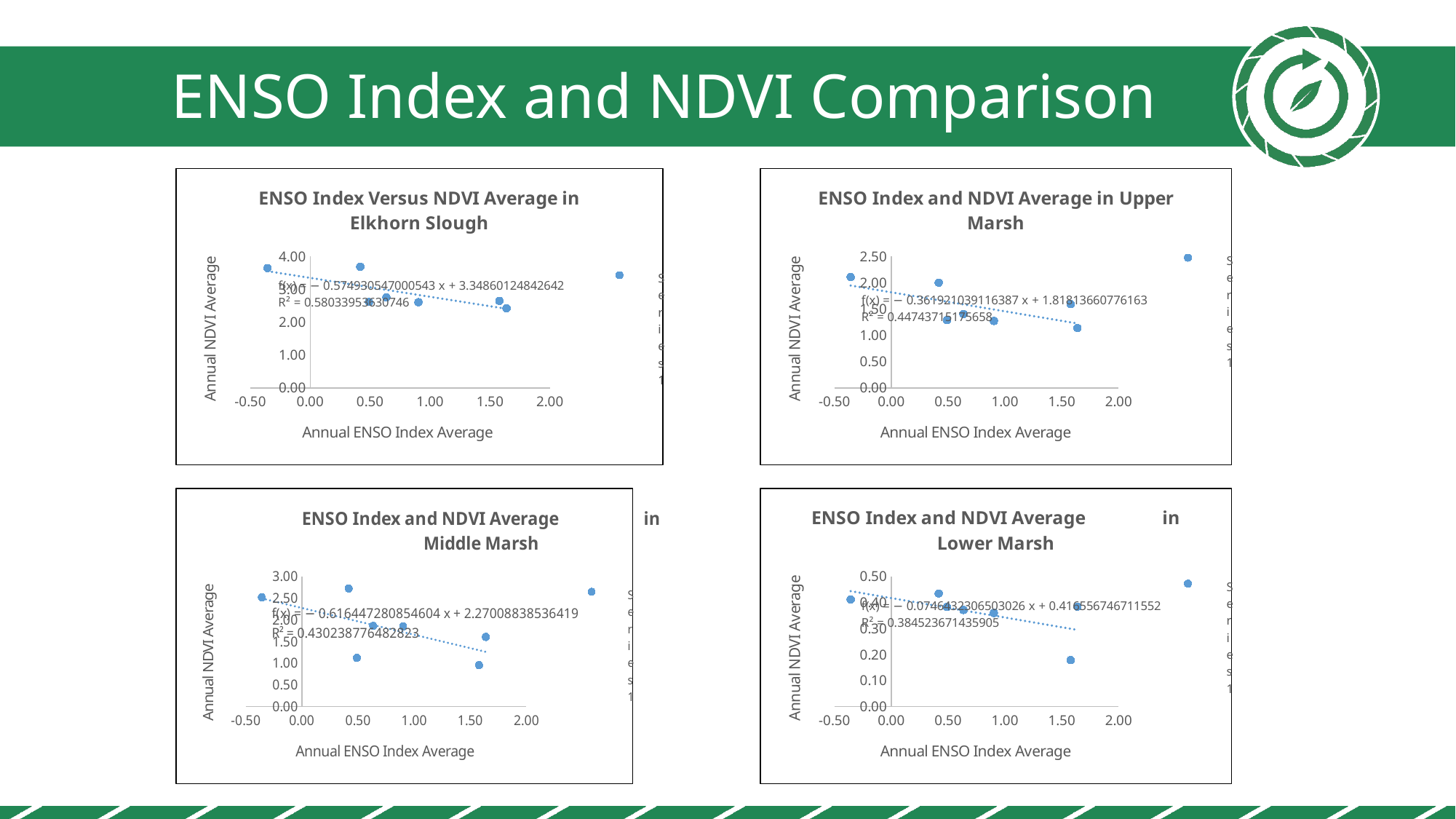
In the 'ENSO Index and NDVI Average in Upper Marsh' chart, what is the R² value printed on the chart? 0.44743715175658 In the 'ENSO Index and NDVI Average in Lower Marsh' chart, what is the R² value printed on the chart? 0.384523671435905 In the 'ENSO Index and NDVI Average in Upper Marsh' chart, does the trendline rise or fall as the ENSO index increases? fall What is the x-axis label of the 'ENSO Index and NDVI Average in Lower Marsh' chart? Annual ENSO Index Average What kind of chart is the 'ENSO Index Versus NDVI Average in Elkhorn Slough' chart? scatter chart Which of the four charts has the highest maximum value on its y axis? ENSO Index Versus NDVI Average in Elkhorn Slough How many charts are shown on the slide? 4 In the 'ENSO Index and NDVI Average in Lower Marsh' chart, what is the trendline equation printed on the chart? f(x) = − 0.0746432306503026 x + 0.416556746711552 In the 'ENSO Index and NDVI Average in Middle Marsh' chart, what is the R² value printed on the chart? 0.430238776482823 In the 'ENSO Index and NDVI Average in Middle Marsh' chart, is the NDVI value for the point at an ENSO index of about 0.50 greater or less than 1.50? less In the 'ENSO Index Versus NDVI Average in Elkhorn Slough' chart, what is the R² value printed on the chart? 0.58033953630746 In the 'ENSO Index and NDVI Average in Lower Marsh' chart, is the NDVI value for the point at an ENSO index of about 1.55 greater or less than 0.30? less